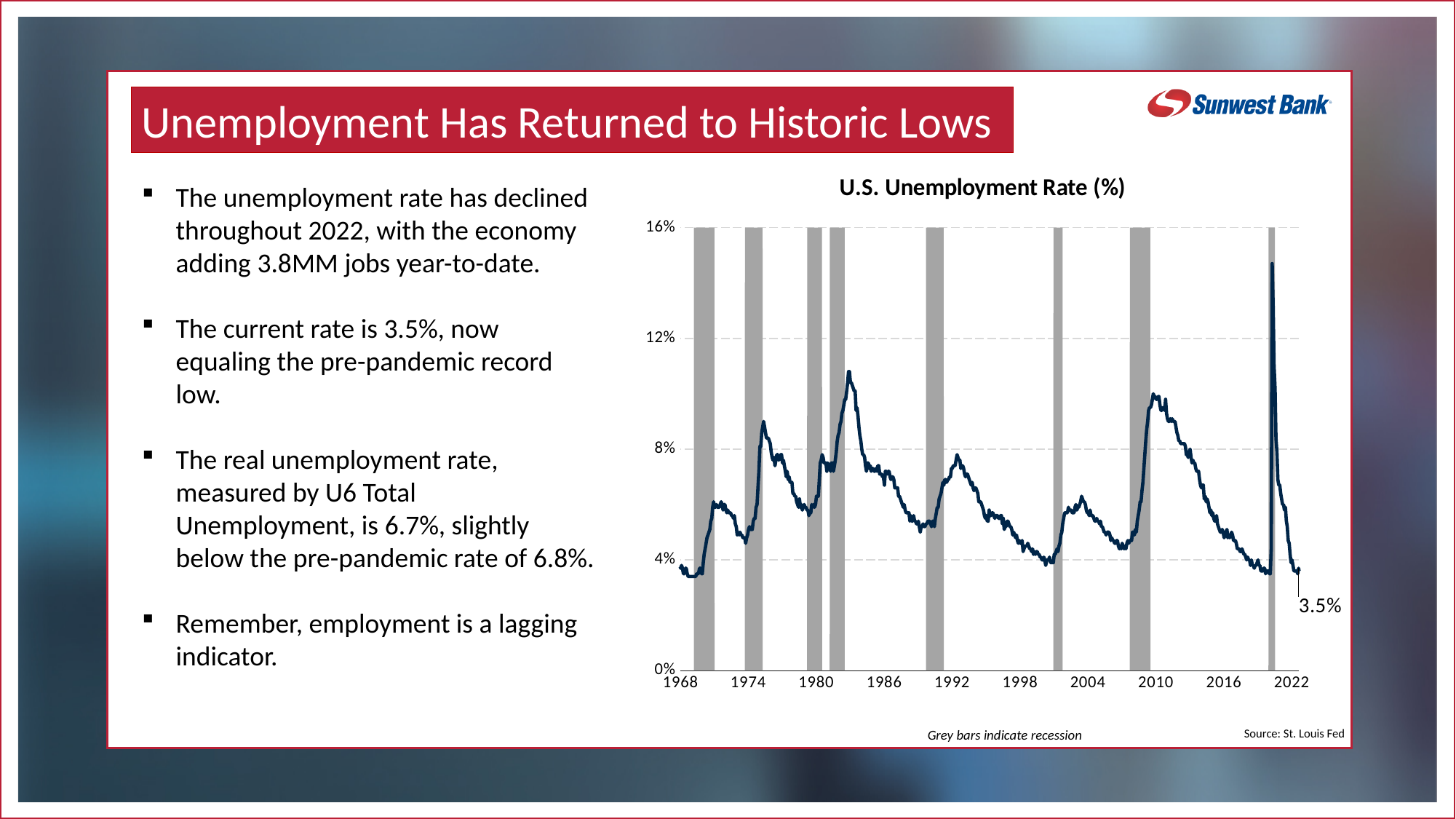
Which peak is higher: the one around 1982 or the one around 1992? 1982 Is the peak unemployment rate around 2010 greater or less than 12%? less What kind of chart is shown on the slide? line chart Is the peak unemployment rate around 2020 greater or less than 12%? greater Is the unemployment rate at the start of the chart in 1968 greater or less than 4%? less According to the note below the chart, what do the grey bars indicate? recession Does the unemployment rate rise or fall between 2010 and 2019? fall What is the unemployment rate value labelled at the end of the line in 2022? 3.5% Around which year does the unemployment rate reach its highest point on the chart? 2020 How many year labels are shown on the x axis? 10 What is the title of the chart? U.S. Unemployment Rate (%)